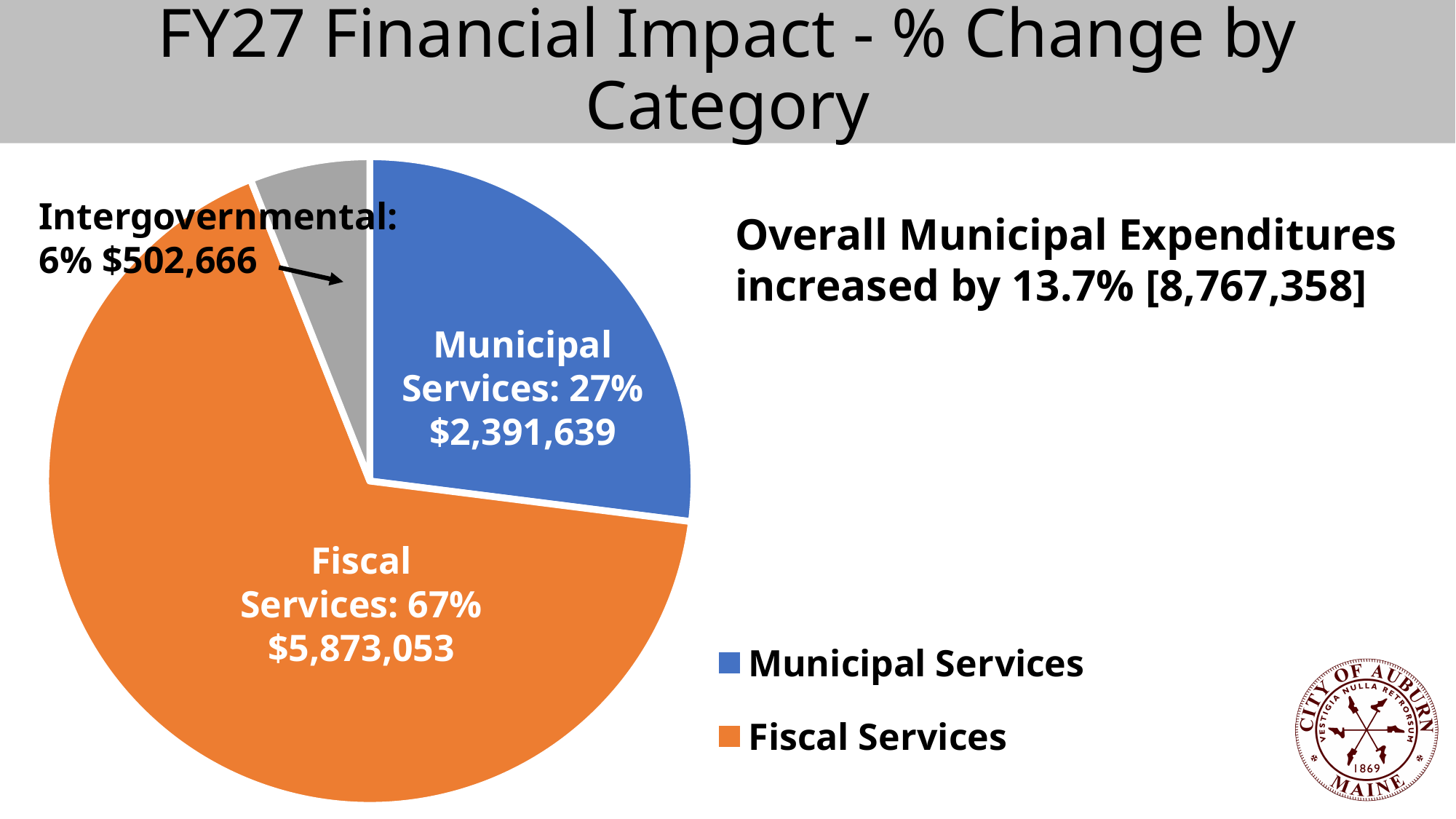
What dollar value is shown for Municipal Services? $2,391,639 How many entries does the legend list? 2 What share of the pie does Municipal Services represent? 27% Which category has the smallest slice of the pie? Intergovernmental What type of chart is shown on the slide? Pie chart Which is larger, the value for Municipal Services or the value for Intergovernmental? Municipal Services What share of the pie does Fiscal Services represent? 67% What dollar value is shown for Intergovernmental? $502,666 What share of the pie does Intergovernmental represent? 6% What dollar value is shown for Fiscal Services? $5,873,053 Which category has the largest slice of the pie? Fiscal Services How many slices does the pie chart have? 3